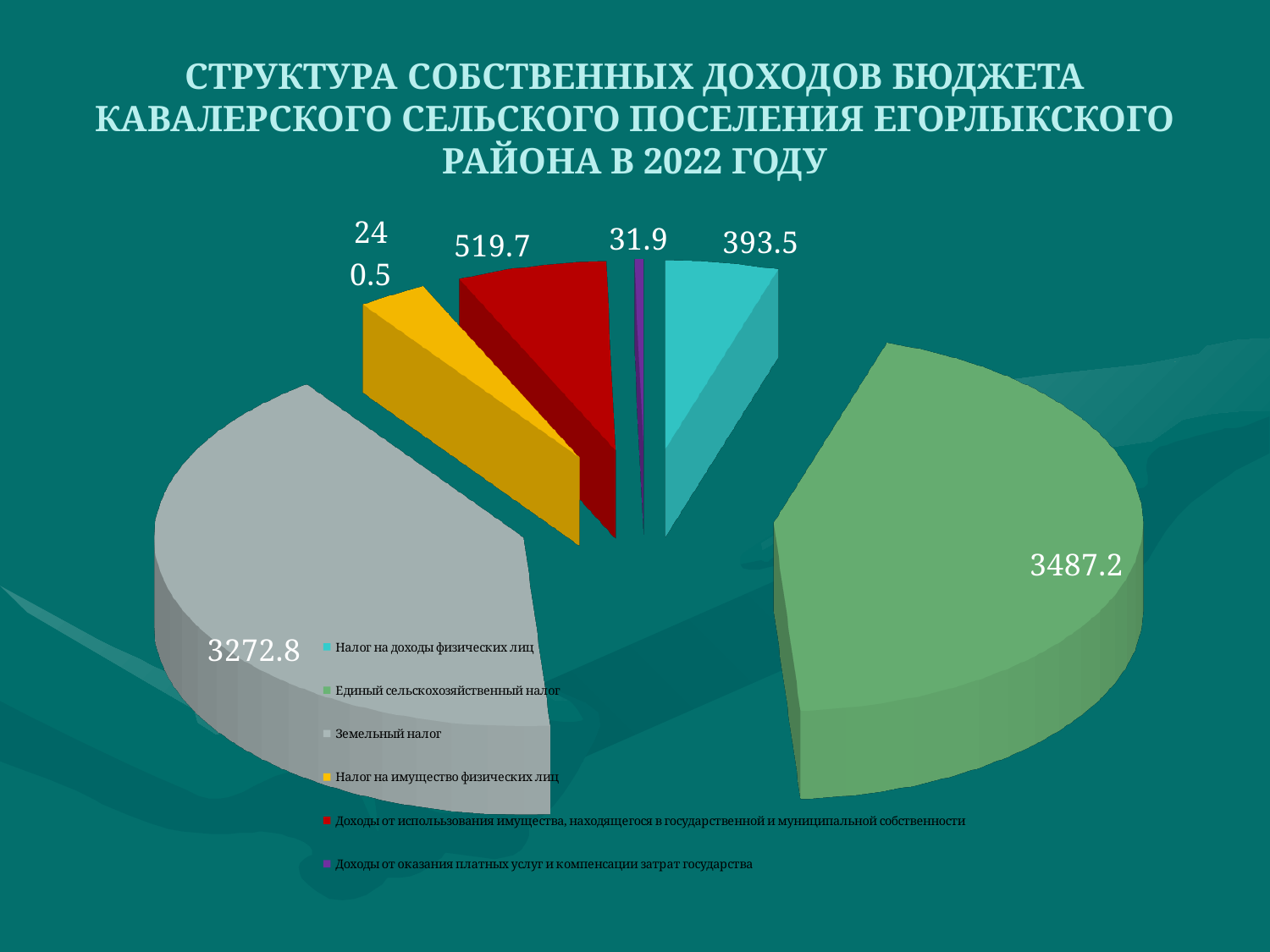
What is the value for Земельный налог? 3272.8 Which category has the largest value? Единый сельскохозяйственный налог What is the value for Доходы от использования имущества, находящегося в государственной и муниципальной собственности? 519.7 How many entries does the legend list? 6 How many slices does the pie chart have? 6 What is the value for Единый сельскохозяйственный налог? 3487.2 What is the value for Доходы от оказания платных услуг и компенсации затрат государства? 31.9 Which category has the smallest value? Доходы от оказания платных услуг и компенсации затрат государства What is the value for Налог на доходы физических лиц? 393.5 What is the difference between the values for Единый сельскохозяйственный налог and Земельный налог? 214.4 Which is larger: the value for Доходы от использования имущества, находящегося в государственной и муниципальной собственности or the value for Налог на доходы физических лиц? Доходы от использования имущества, находящегося в государственной и муниципальной собственности What kind of chart is shown on the slide? Pie chart